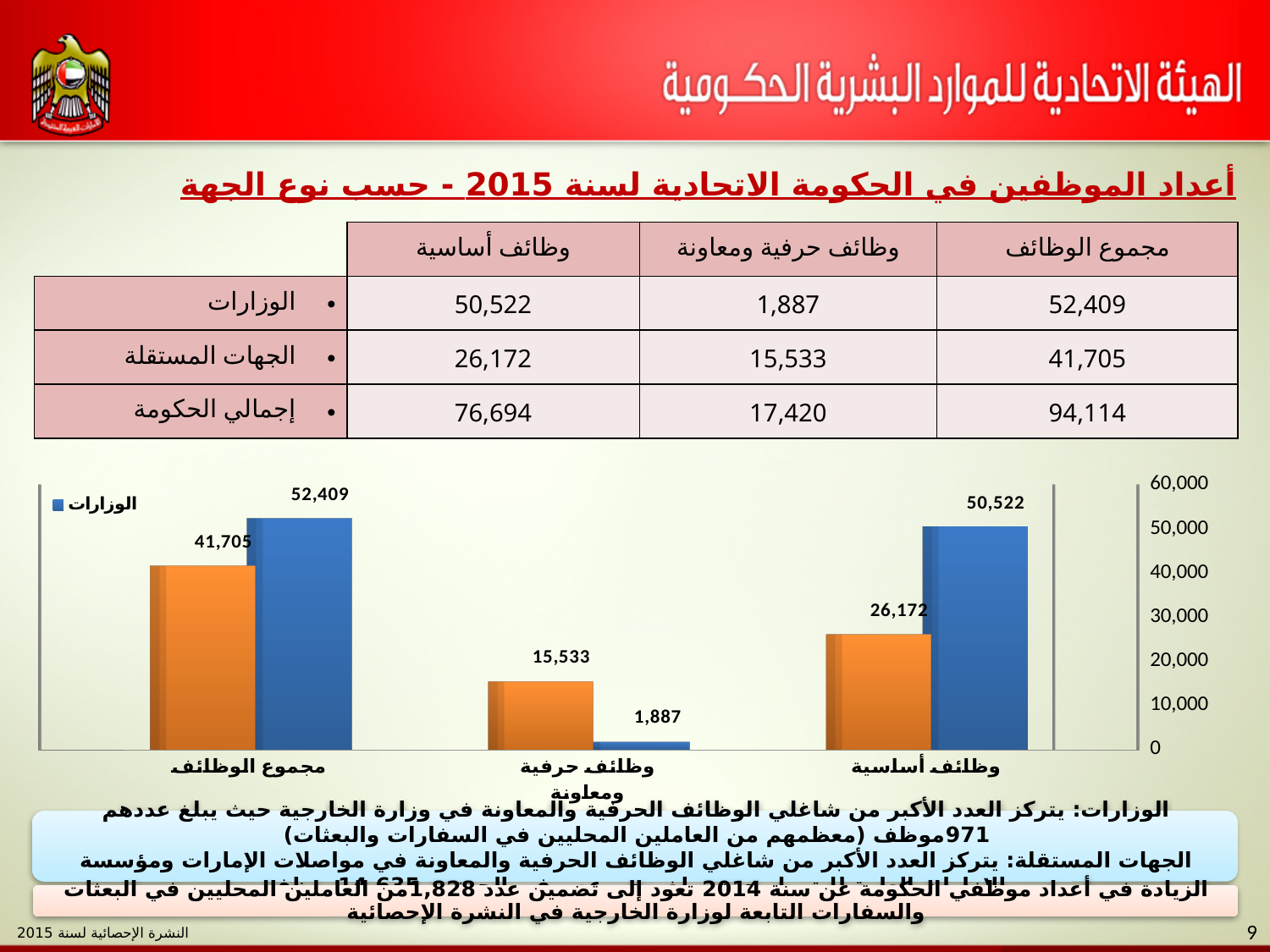
What kind of chart is shown on the slide? bar chart What is the value of the blue bar (الوزارات) for مجموع الوظائف? 52,409 Which category has the lowest blue bar (الوزارات)? وظائف حرفية ومعاونة How many categories are shown on the x axis of the chart? 3 What is the value of the orange bar for مجموع الوظائف? 41,705 What is the difference between the orange bar and the blue bar for وظائف حرفية ومعاونة? 13,646 What is the difference between the blue bar and the orange bar for مجموع الوظائف? 10,704 For وظائف أساسية, which bar is larger, the blue bar or the orange bar? the blue bar Which category has the highest blue bar (الوزارات)? مجموع الوظائف What is the value of the blue bar (الوزارات) for وظائف أساسية? 50,522 What is the value of the orange bar for وظائف حرفية ومعاونة? 15,533 What is the value of the blue bar (الوزارات) for وظائف حرفية ومعاونة? 1,887